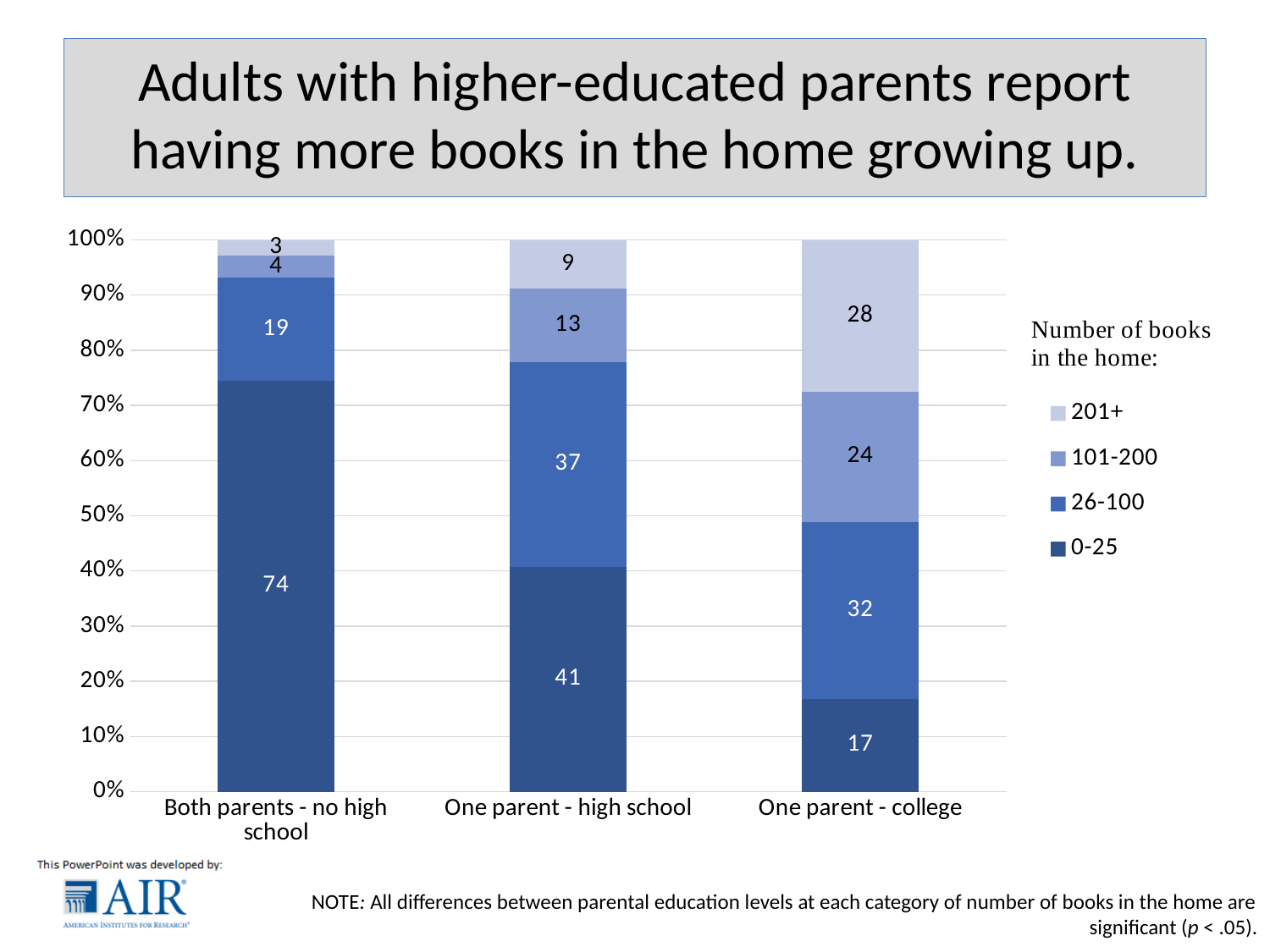
What is the title of the legend? Number of books in the home: How many parental education categories are shown on the x axis? 3 Which parental education category has the highest value for 0-25 books? Both parents - no high school What is the difference between the 0-25 values for 'Both parents - no high school' and 'One parent - college'? 57 What is the value for 201+ books for 'One parent - college'? 28 What is the value for 26-100 books for 'One parent - high school'? 37 What type of chart is shown on the slide? Stacked bar chart How many series does the legend list? 4 Which parental education category has the lowest value for 201+ books? Both parents - no high school Which is larger: the 26-100 value for 'One parent - high school' or for 'One parent - college'? One parent - high school What is the value for 0-25 books for 'Both parents - no high school'? 74 What is the value for 101-200 books for 'One parent - college'? 24